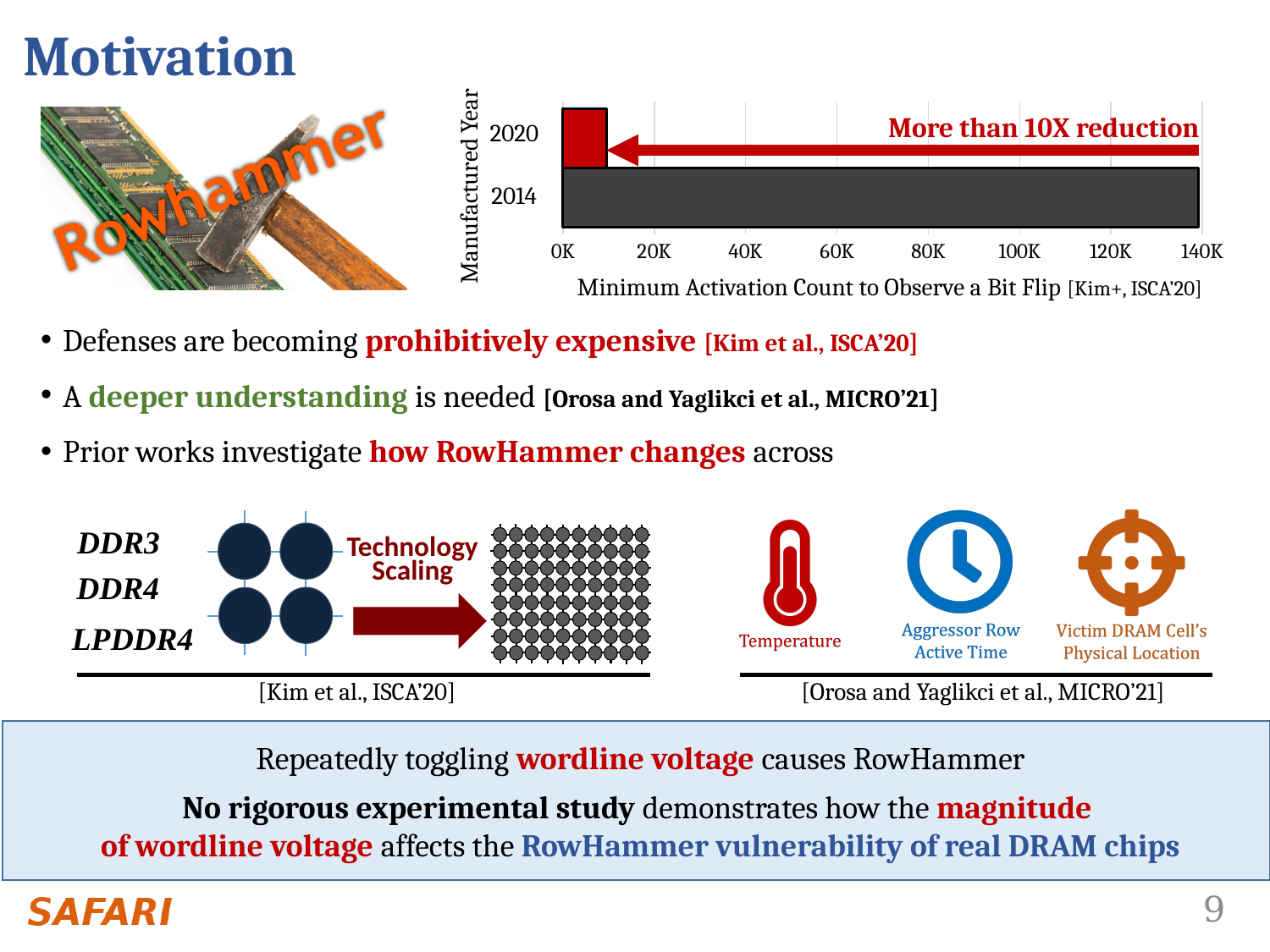
Is the value for 2014 greater or less than 100K? greater What reduction does the annotation on the chart state between 2014 and 2020? More than 10X reduction Is the value for 2020 greater or less than 40K? less What kind of chart is shown on the slide? bar chart Which manufactured year has the lower minimum activation count to observe a bit flip? 2020 Which manufactured year has the higher minimum activation count to observe a bit flip? 2014 Is the value for 2014 greater or less than 120K? greater How many manufactured years are plotted in the chart? 2 Is the minimum activation count for 2014 larger or smaller than for 2020? larger What is the label of the x axis of the chart? Minimum Activation Count to Observe a Bit Flip